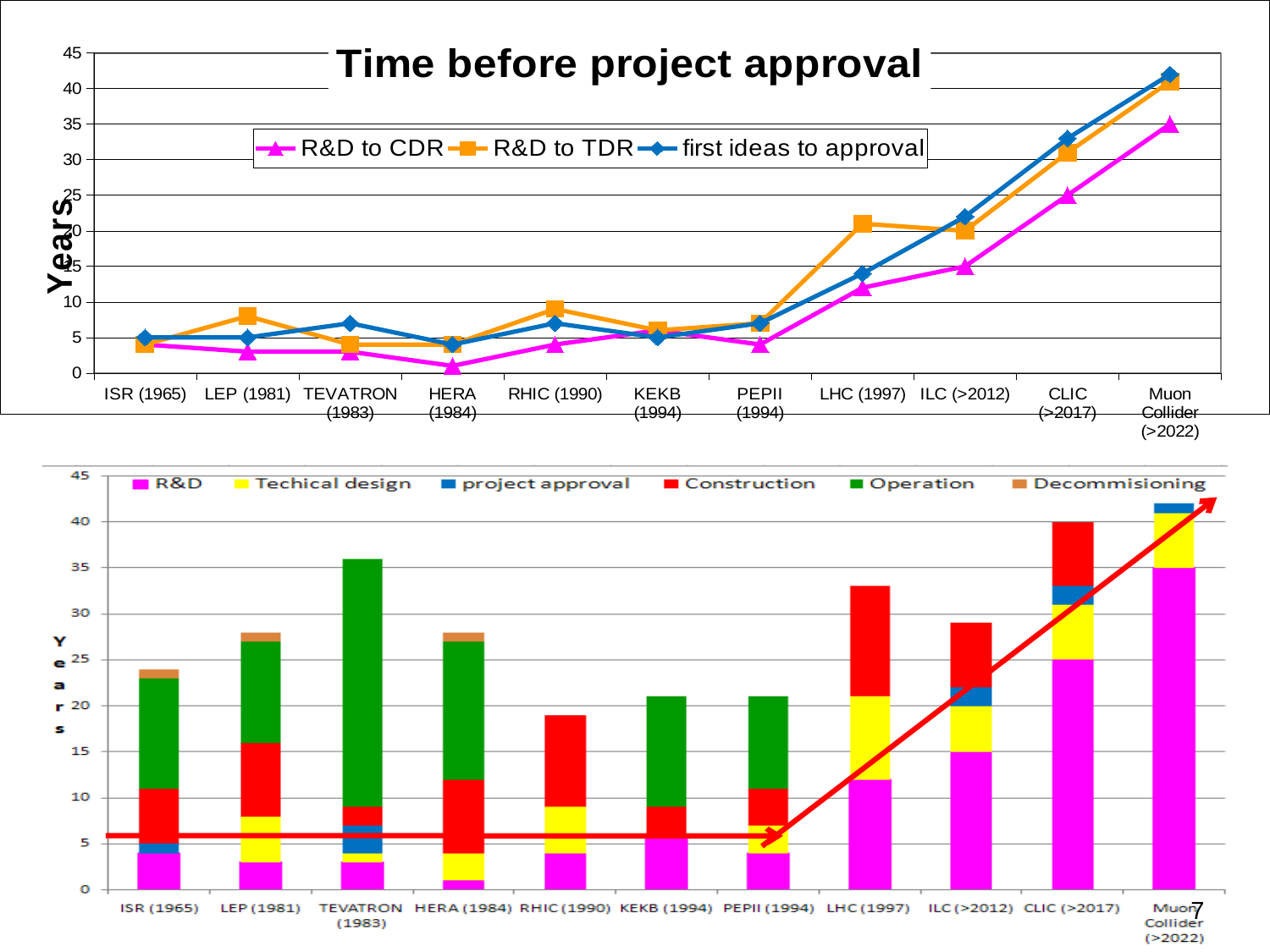
In the top chart 'Time before project approval', which project has the lowest value for 'R&D to CDR'? HERA (1984) What kind of chart is the bottom chart? stacked bar chart In the top chart 'Time before project approval', is the 'R&D to TDR' value for ISR (1965) greater or less than 10? less In the top chart 'Time before project approval', which project has the highest value for 'first ideas to approval'? Muon Collider (>2022) How many projects are shown along the x axis of the top chart 'Time before project approval'? 11 What is the title of the top chart? Time before project approval What kind of chart is the top chart, 'Time before project approval'? line chart How many series does the legend of the bottom chart list? 6 In the bottom chart, is the total bar height for TEVATRON (1983) larger or smaller than that for LEP (1981)? larger In the top chart 'Time before project approval', is the 'first ideas to approval' value for Muon Collider (>2022) greater or less than 40? greater In the top chart 'Time before project approval', do the 'first ideas to approval' values rise or fall from LHC (1997) to Muon Collider (>2022)? rise How many series does the legend of the top chart 'Time before project approval' list? 3